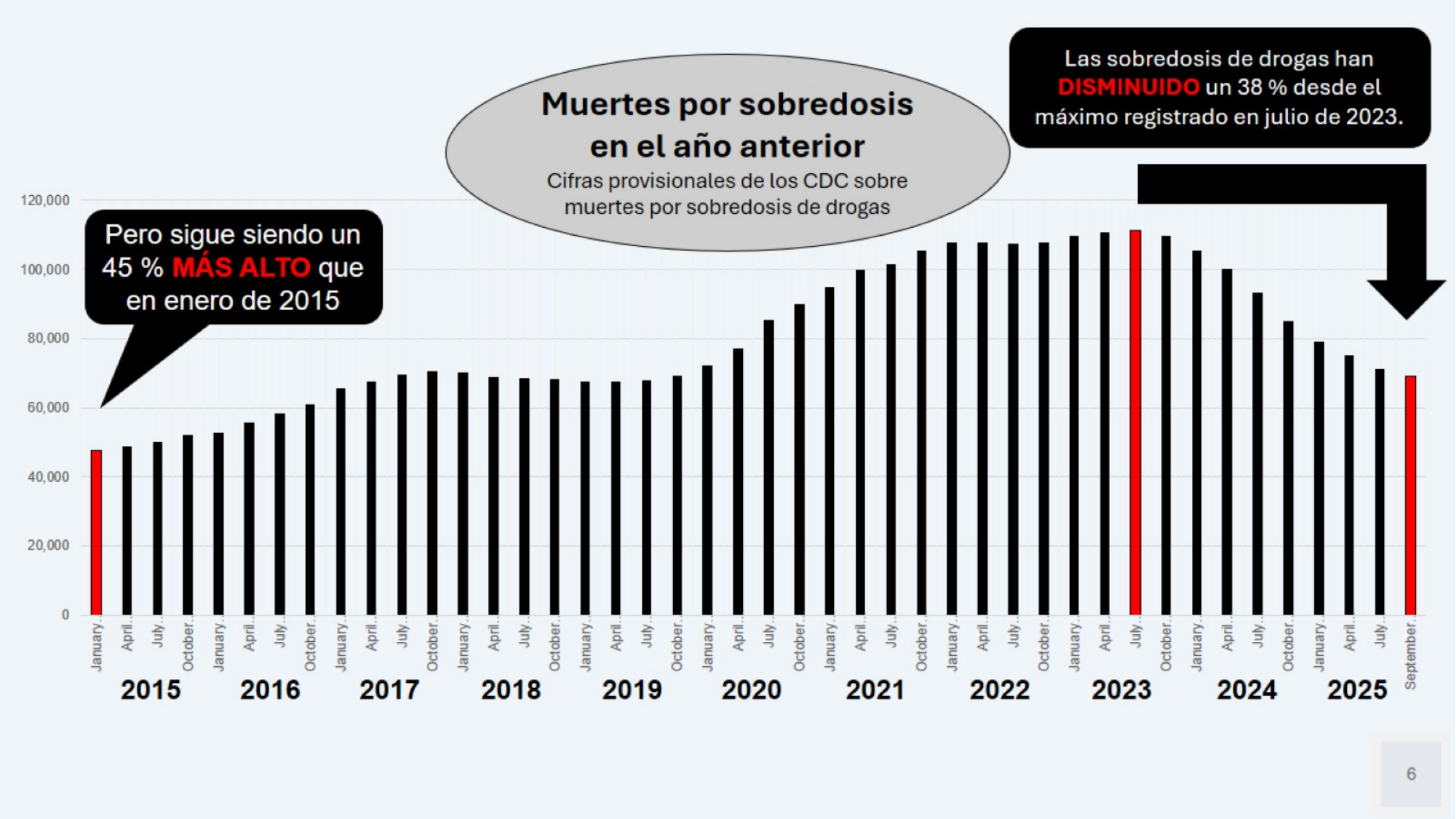
Is the value for January 2015 greater or less than 60,000? less Do the values rise or fall from July 2023 to September 2025? fall Which period has the lowest bar in the chart? January 2015 Which is larger, the value for January 2015 or the value for September 2025? September 2025 What is the title of the chart? Muertes por sobredosis en el año anterior Is the value for September 2025 greater or less than 80,000? less Is the value for July 2024 greater or less than 100,000? less What kind of chart is shown on the slide? bar chart Which is larger, the value for January 2016 or the value for January 2018? January 2018 How many bars are plotted in the chart? 44 Which period has the highest bar in the chart? July 2023